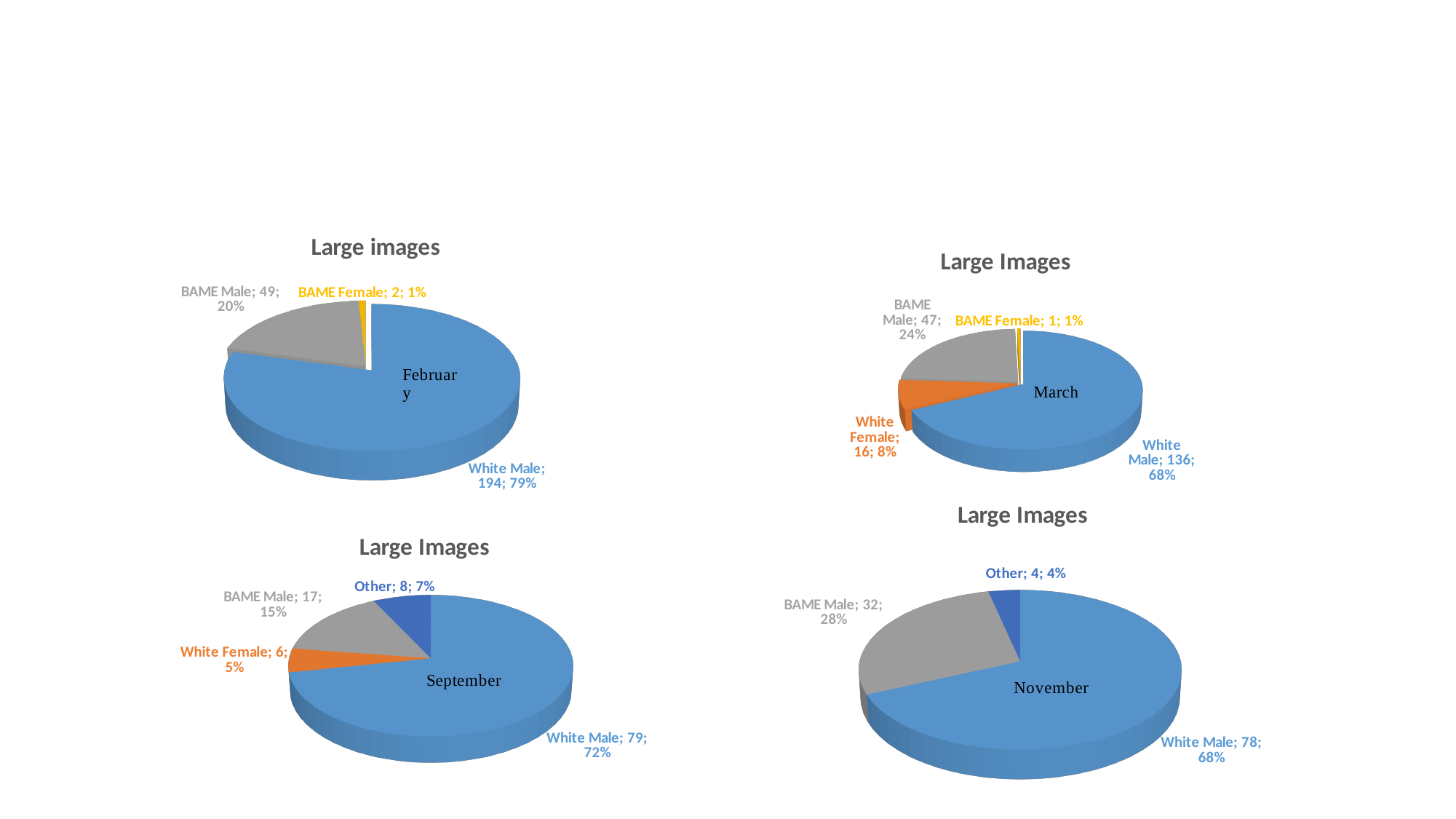
In the March pie chart (top right), what share of the pie is White Female? 8% How many slices does the November pie chart (bottom right) have? 3 In the September pie chart (bottom left), what is the value for Other? 8 What kind of chart is the September chart (bottom left)? Pie chart In the September pie chart (bottom left), which category has the largest slice? White Male In the November pie chart (bottom right), what share of the pie is BAME Male? 28% In the November pie chart (bottom right), which is larger, BAME Male or Other? BAME Male What is the title of the February chart (top left)? Large images How many slices does the March pie chart (top right) have? 4 In the February pie chart (top left), what is the difference between the White Male and BAME Male values? 145 In the March pie chart (top right), which category has the smallest slice? BAME Female In the February pie chart (top left), what is the value for White Male? 194